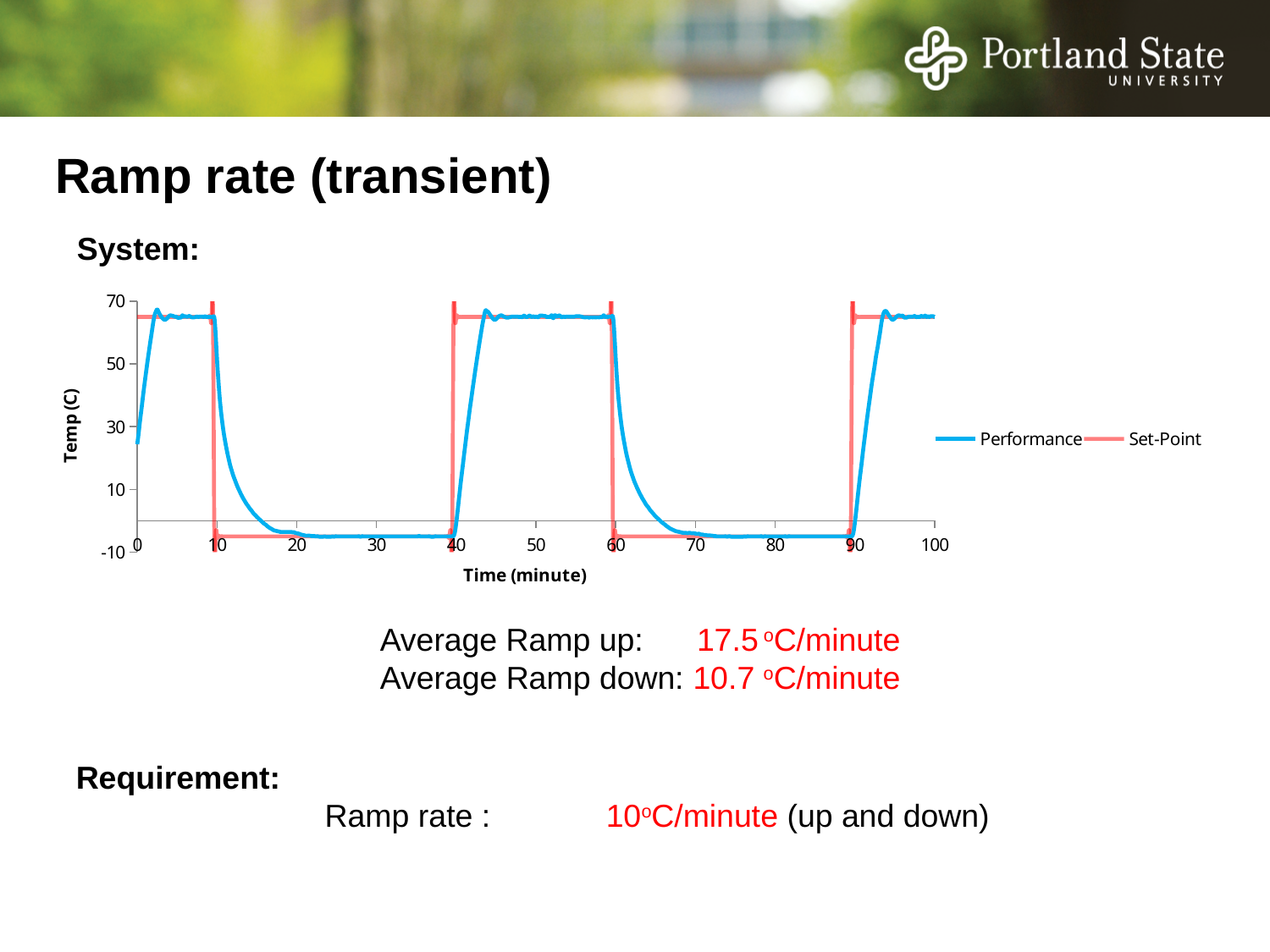
Is the Performance value at 50 minutes greater or less than 50? greater Between 90 and 95 minutes, does the Performance line rise or fall? rise Is the Performance value at 30 minutes greater or less than 10? less Is the Set-Point value at 5 minutes greater or less than 50? greater At 15 minutes, which series has the larger value, Performance or Set-Point? Performance What is the title of the chart's x axis? Time (minute) How many series does the chart's legend list? 2 At 42 minutes, which series has the larger value, Performance or Set-Point? Set-Point What are the two series named in the chart's legend? Performance and Set-Point What kind of chart is shown on the slide? line chart Between 10 and 20 minutes, does the Performance line rise or fall? fall